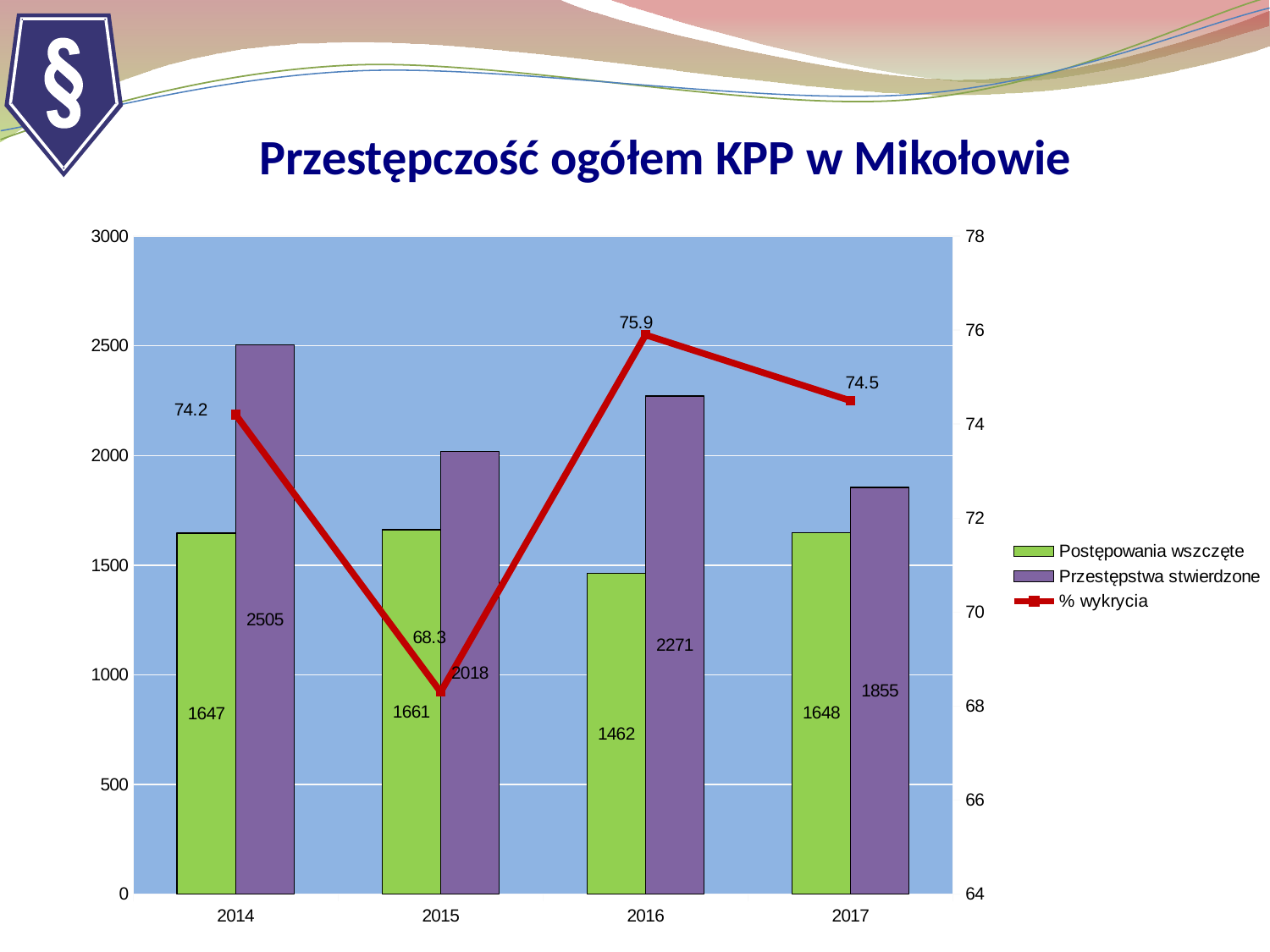
How many series does the legend list? 3 What is the title of the chart? Przestępczość ogółem KPP w Mikołowie Does the % wykrycia line rise or fall from 2016 to 2017? fall What is the % wykrycia value for 2015? 68.3 How many years are shown on the x axis? 4 What is the value of Przestępstwa stwierdzone in 2014? 2505 Which year has the highest value of Przestępstwa stwierdzone? 2014 Which year has the lowest % wykrycia? 2015 Is the value of Przestępstwa stwierdzone in 2015 greater or less than 2000? greater What is the value of Postępowania wszczęte in 2016? 1462 Which is larger: Postępowania wszczęte in 2015 or in 2017? 2015 What is the difference between Przestępstwa stwierdzone in 2016 and 2017? 416